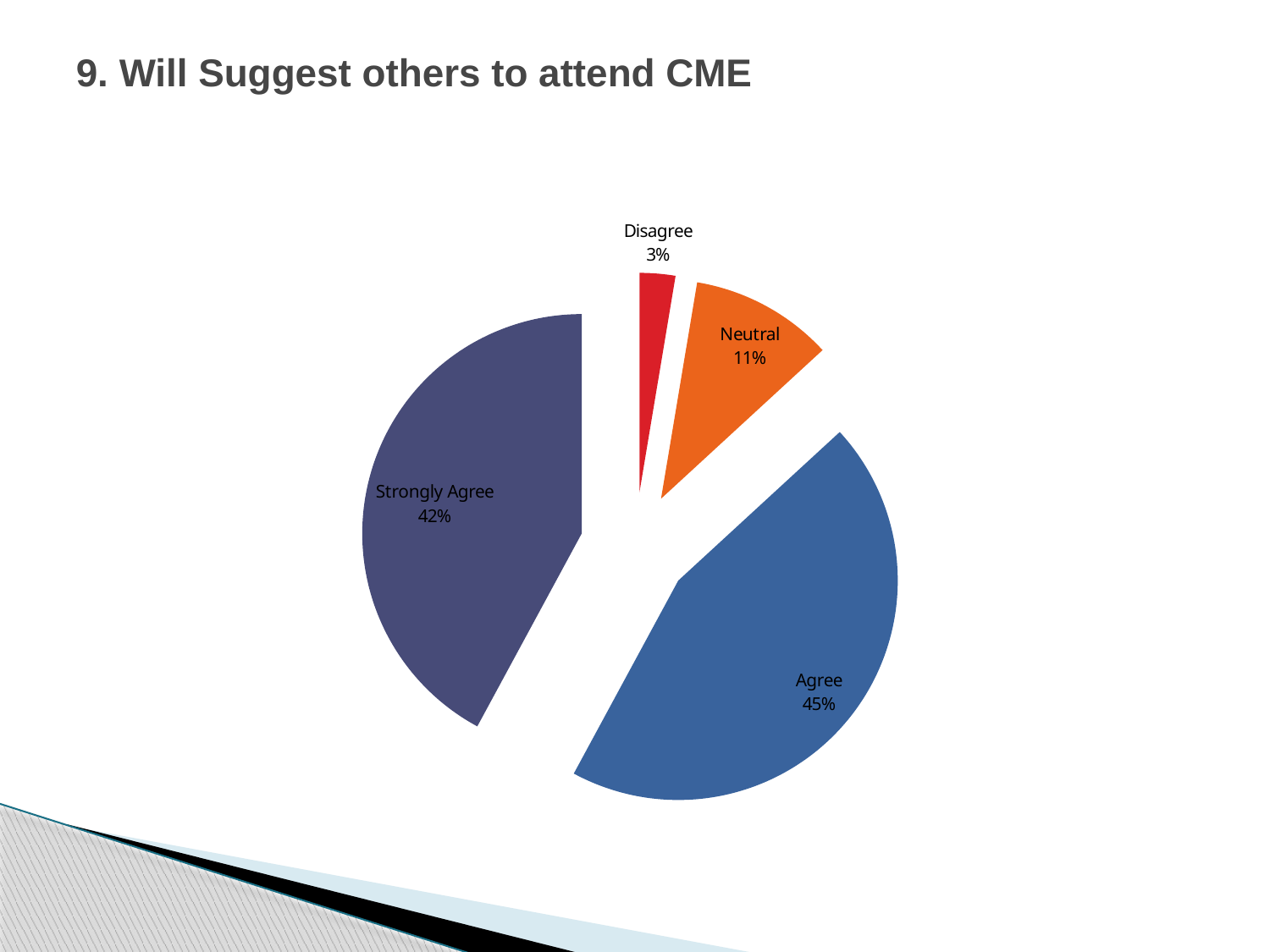
What is the title of the slide containing the pie chart? 9. Will Suggest others to attend CME Which response has the smallest share of the pie? Disagree Which is larger, the share for Neutral or the share for Disagree? Neutral What is the difference in percentage points between Neutral and Disagree? 8 What percentage of respondents chose Disagree? 3% What is the difference in percentage points between Agree and Strongly Agree? 3 What percentage of respondents chose Neutral? 11% What percentage of respondents chose Strongly Agree? 42% What percentage of respondents chose Agree? 45% What type of chart is shown on the slide? pie chart How many slices does the pie chart have? 4 Which response has the largest share of the pie? Agree